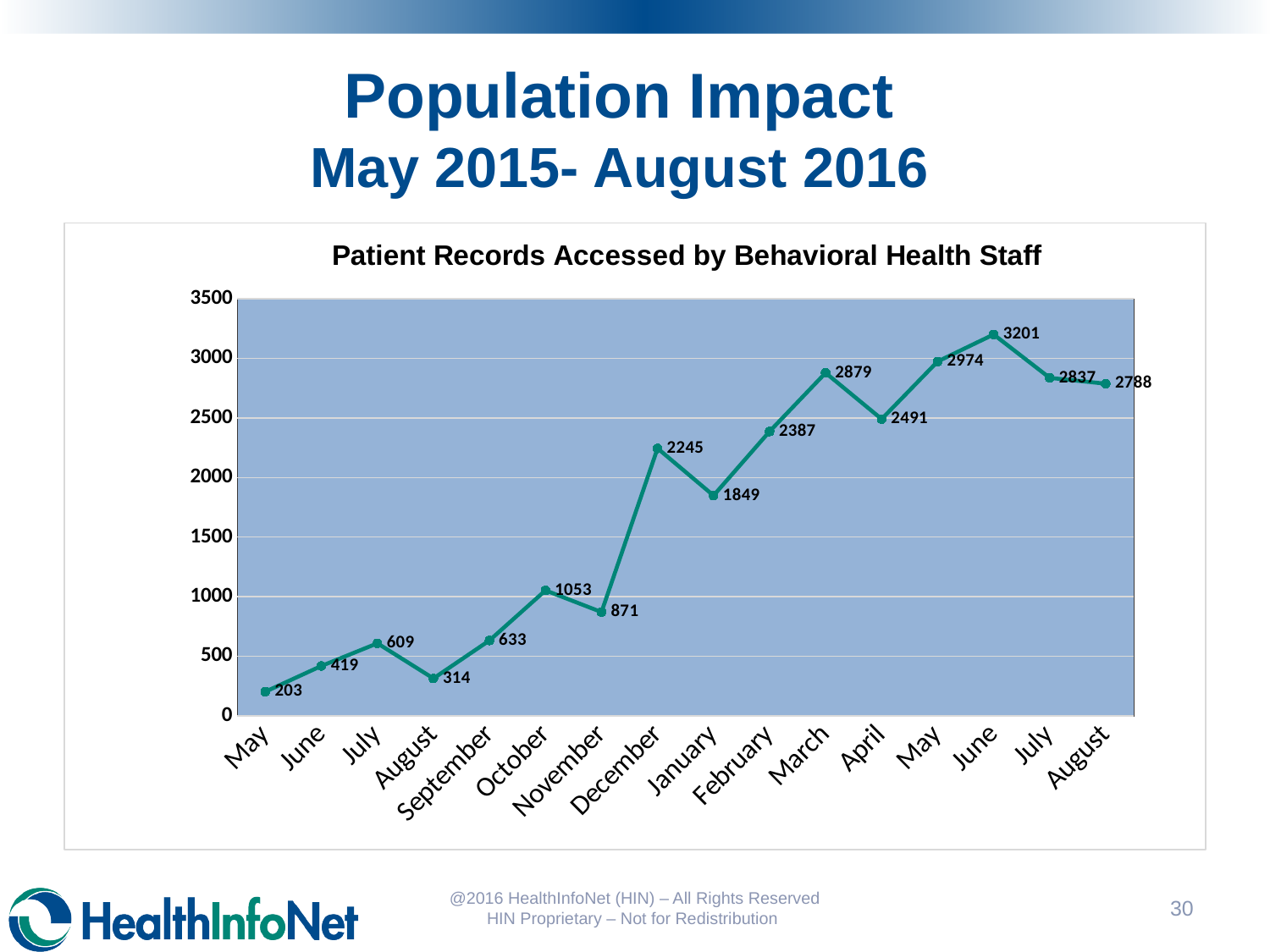
What is the value for March? 2879 Is the value for September greater or less than 500? greater Which is larger, the value for February or the value for January? February What is the value for December? 2245 Overall, do the values rise or fall from May 2015 to August 2016? rise How many data points are plotted on the line? 16 What is the difference between the values for December and November? 1374 What is the value for October? 1053 Which month has the highest value? June (2016) What type of chart is shown on the slide? line chart What is the title of the chart? Patient Records Accessed by Behavioral Health Staff Which month has the lowest value? May (2015)